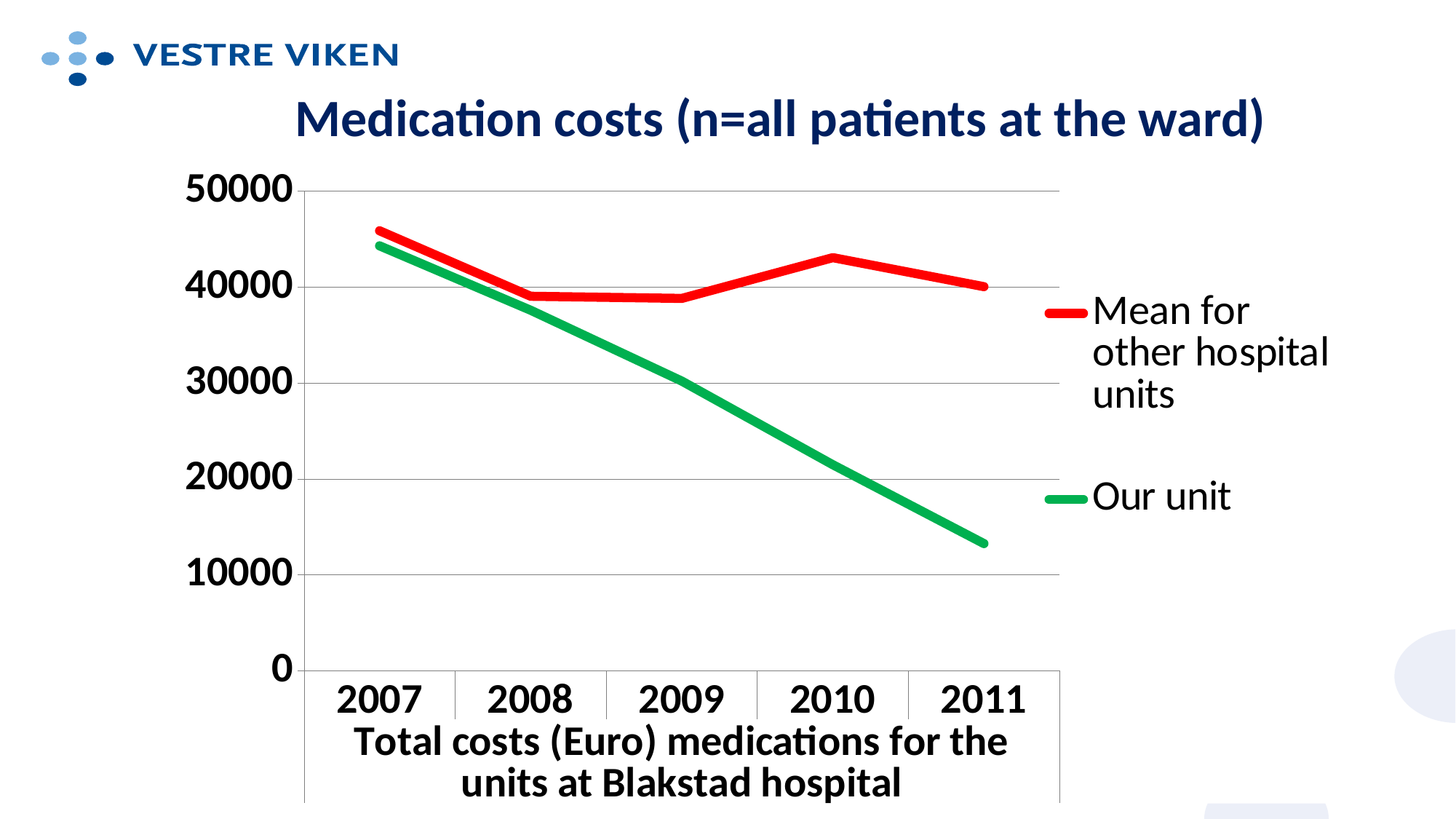
Is the value for Mean for other hospital units in 2010 greater or less than 40000? greater In which year is the value for Mean for other hospital units highest? 2007 How many series does the legend list? 2 How many years are shown on the x axis? 5 In which year is the value for Our unit highest? 2007 In 2011, which series has the larger value, Our unit or Mean for other hospital units? Mean for other hospital units Is the value for Our unit in 2007 greater or less than 40000? greater Is the value for Our unit in 2011 greater or less than 20000? less What kind of chart is shown on the slide? line chart What is the title of the chart? Medication costs (n=all patients at the ward) In which year is the value for Our unit lowest? 2011 Does the value for Our unit rise or fall from 2007 to 2011? fall